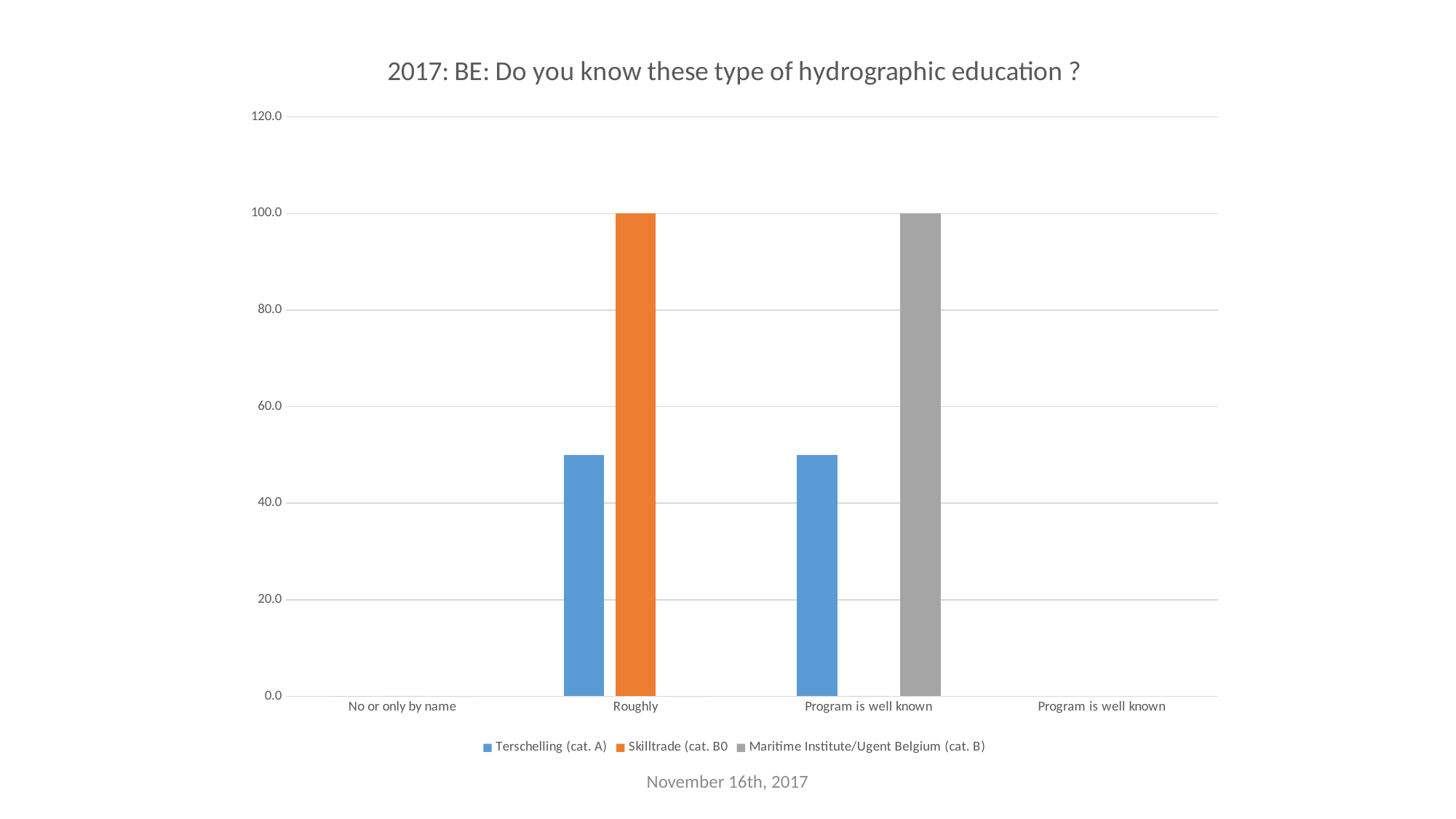
How many series does the legend list? 3 What is the value for Skilltrade (cat. B0) in the Roughly category? 100.0 What type of chart is shown on the slide? bar chart In which category does Skilltrade (cat. B0) have its highest value? Roughly What is the value for Maritime Institute/Ugent Belgium (cat. B) in the third category from the left (Program is well known)? 100.0 How many categories are shown on the x axis? 4 Is the value for Terschelling (cat. A) in the Roughly category greater or less than 60.0? less Which series is shown in orange in the legend? Skilltrade (cat. B0) Is the value for Terschelling (cat. A) in the Roughly category greater or less than 40.0? greater What is the title of the chart? 2017: BE: Do you know these type of hydrographic education ? Is the value for Maritime Institute/Ugent Belgium (cat. B) in the third category from the left (Program is well known) greater or less than 80.0? greater In the Roughly category, which series has the larger value, Terschelling (cat. A) or Skilltrade (cat. B0)? Skilltrade (cat. B0)